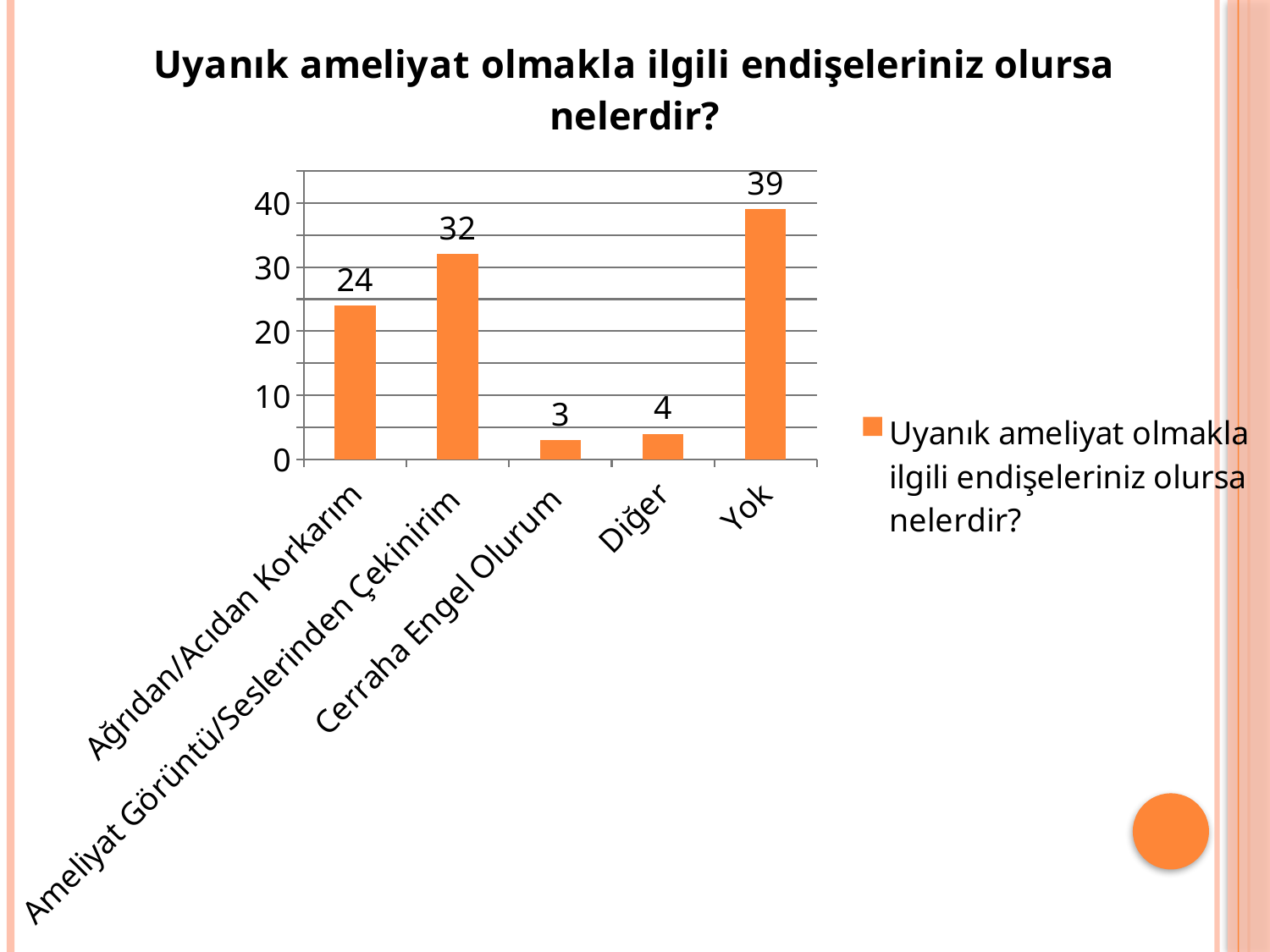
What is the difference between the values for Yok and Ameliyat Görüntü/Seslerinden Çekinirim? 7 What kind of chart is shown on the slide? bar chart What is the value for Cerraha Engel Olurum? 3 How many categories are shown on the x axis? 5 What is the title of the chart? Uyanık ameliyat olmakla ilgili endişeleriniz olursa nelerdir? Is the value for Ameliyat Görüntü/Seslerinden Çekinirim greater or less than 30? greater What is the value for Yok? 39 What is the value for Diğer? 4 What is the value for Ağrıdan/Acıdan Korkarım? 24 Which is larger, the value for Ağrıdan/Acıdan Korkarım or the value for Ameliyat Görüntü/Seslerinden Çekinirim? Ameliyat Görüntü/Seslerinden Çekinirim Which category has the highest value? Yok Which category has the lowest value? Cerraha Engel Olurum